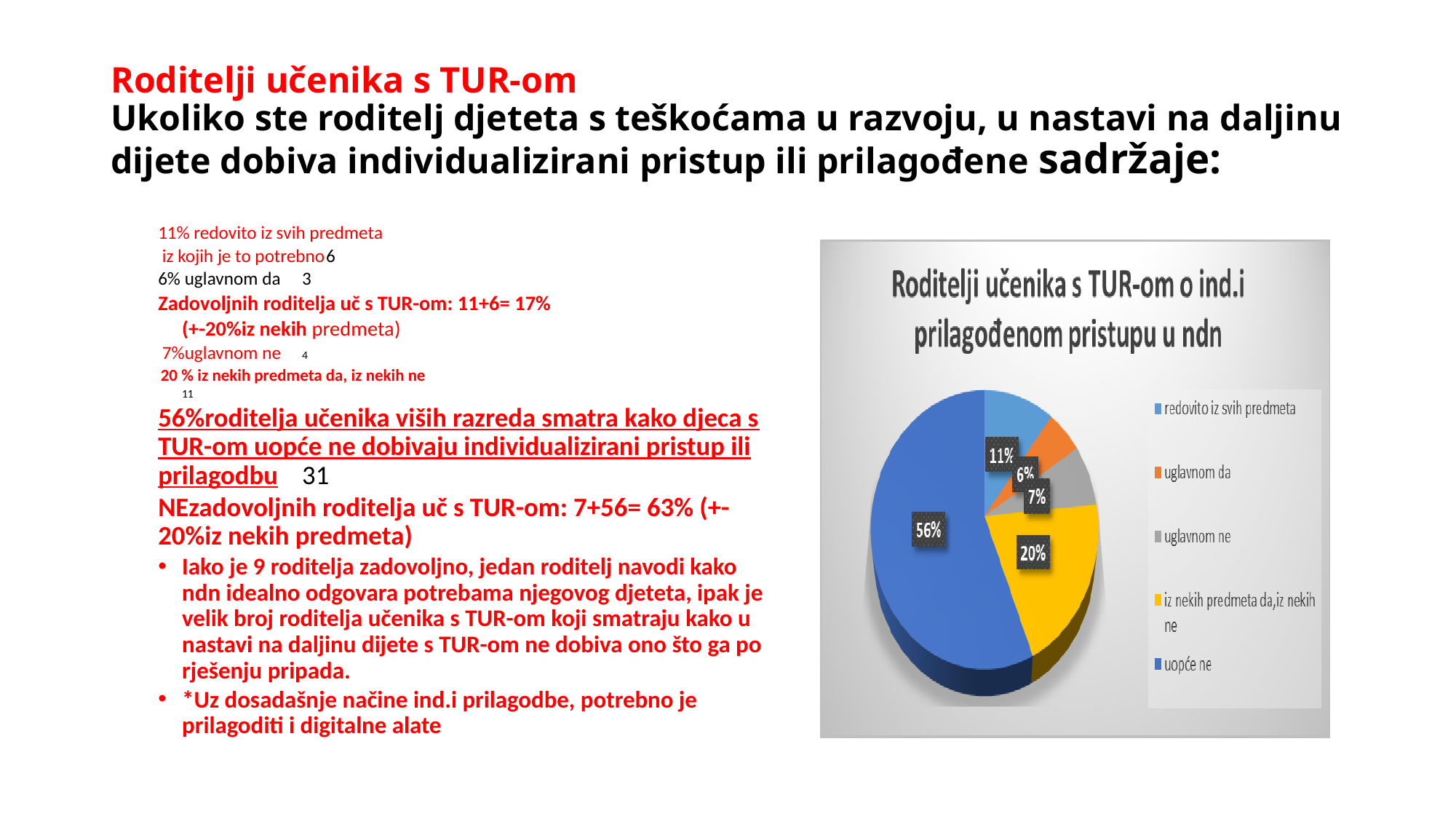
Which is larger, 'redovito iz svih predmeta' or 'uglavnom ne'? redovito iz svih predmeta How many categories does the pie chart have? 5 Which category has the smallest slice of the pie? uglavnom da What kind of chart is shown on the slide? pie chart What is the title of the chart? Roditelji učenika s TUR-om o ind.i prilagođenom pristupu u ndn What share of the pie does 'uopće ne' take? 56% What is the value for 'iz nekih predmeta da, iz nekih ne'? 20% Which category has the largest slice of the pie? uopće ne What is the difference between the 'uopće ne' slice and the 'iz nekih predmeta da, iz nekih ne' slice? 36% What is the value for 'redovito iz svih predmeta'? 11% What is the value for 'uglavnom da'? 6% What is the value for 'uglavnom ne'? 7%